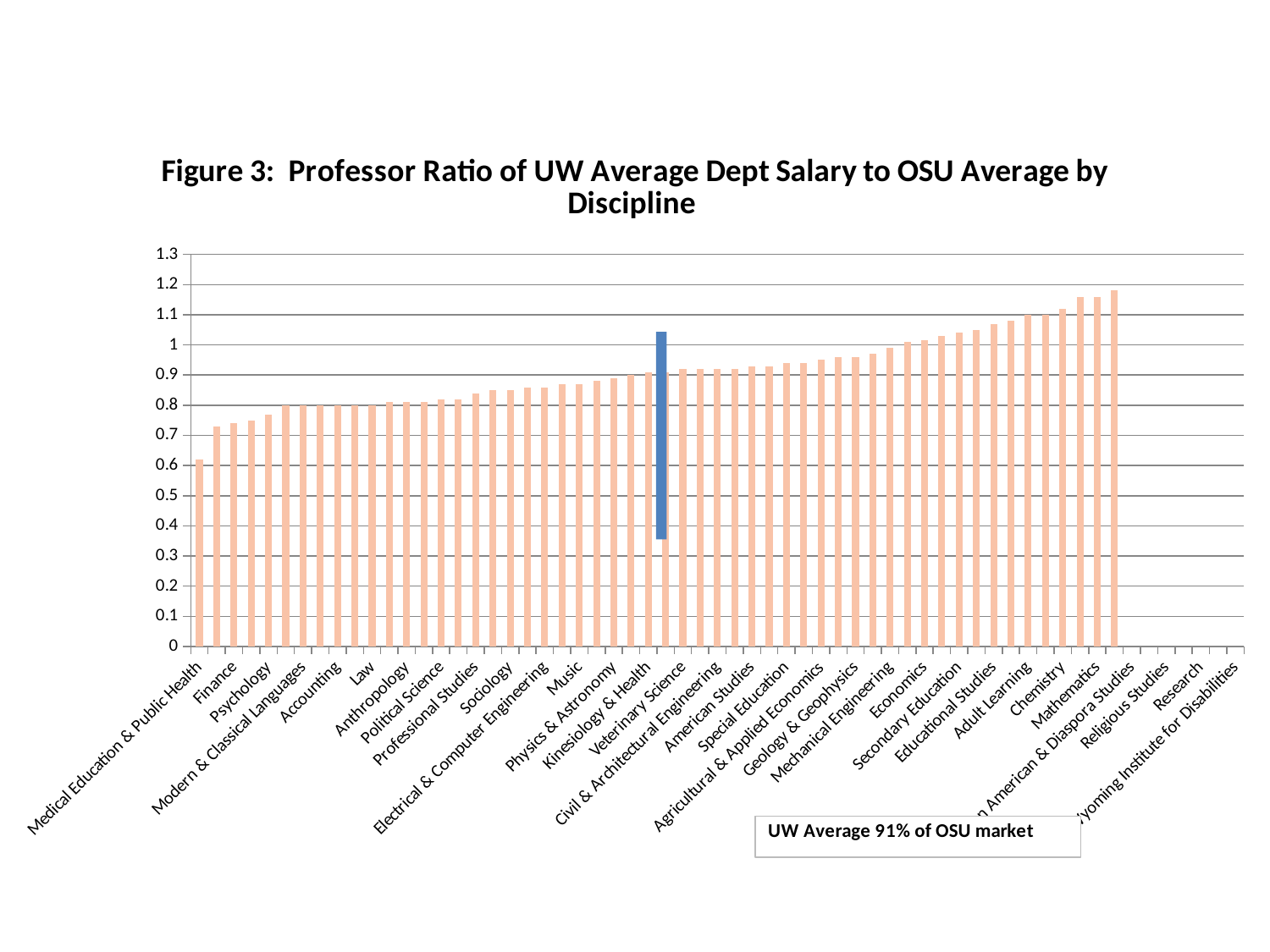
Do the bar values generally rise or fall from left to right along the x axis? rise Is the value for Medical Education & Public Health greater or less than 0.7? less According to the text box on the chart, the UW average is what percent of the OSU market? 91% Is the value for Mathematics greater or less than 1.1? greater Is the value for Music greater or less than 0.8? greater Which has the larger ratio, Chemistry or Psychology? Chemistry Which has the larger ratio, Mathematics or Medical Education & Public Health? Mathematics Which labeled discipline has the lowest ratio? Medical Education & Public Health What is the title of the chart? Figure 3: Professor Ratio of UW Average Dept Salary to OSU Average by Discipline What kind of chart is shown on the slide? bar chart